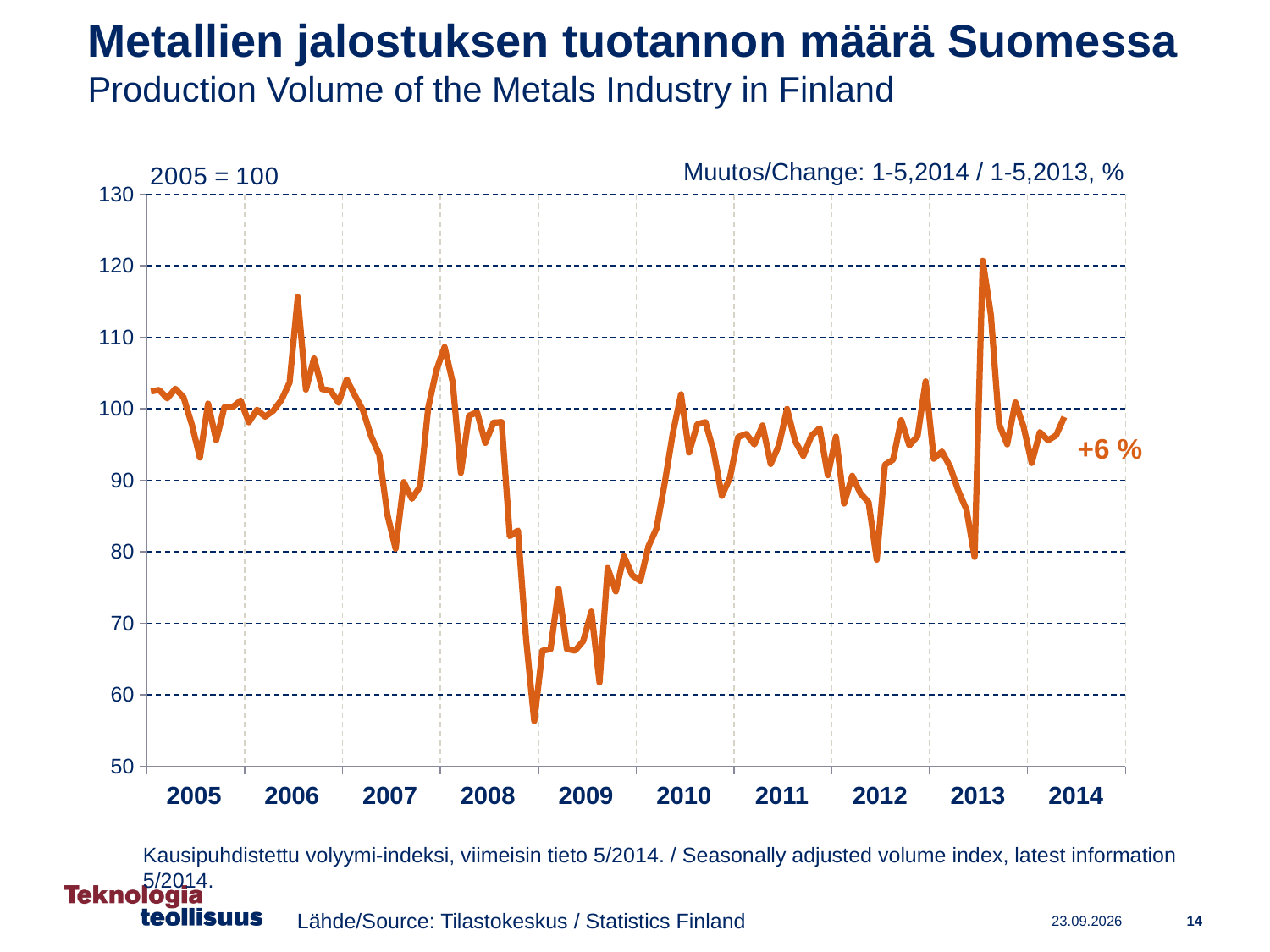
What percentage change for 1-5,2014 / 1-5,2013 is annotated on the chart? +6 % What base year and value is the index set to, as shown above the chart? 2005 = 100 How many year labels are shown on the x axis? 10 Is the highest value reached by the line greater or less than 110? greater What is the title of the chart in English? Production Volume of the Metals Industry in Finland What is the highest value shown on the y axis? 130 Does the line rise or fall from the start of 2009 to the start of 2010? rise Does the line rise or fall from the start of 2008 to the start of 2009? fall Is the lowest value reached by the line greater or less than 60? less What kind of chart is shown on the slide? line chart How many lines are plotted on the chart? 1 Is the peak value in 2006 greater or less than 110? greater